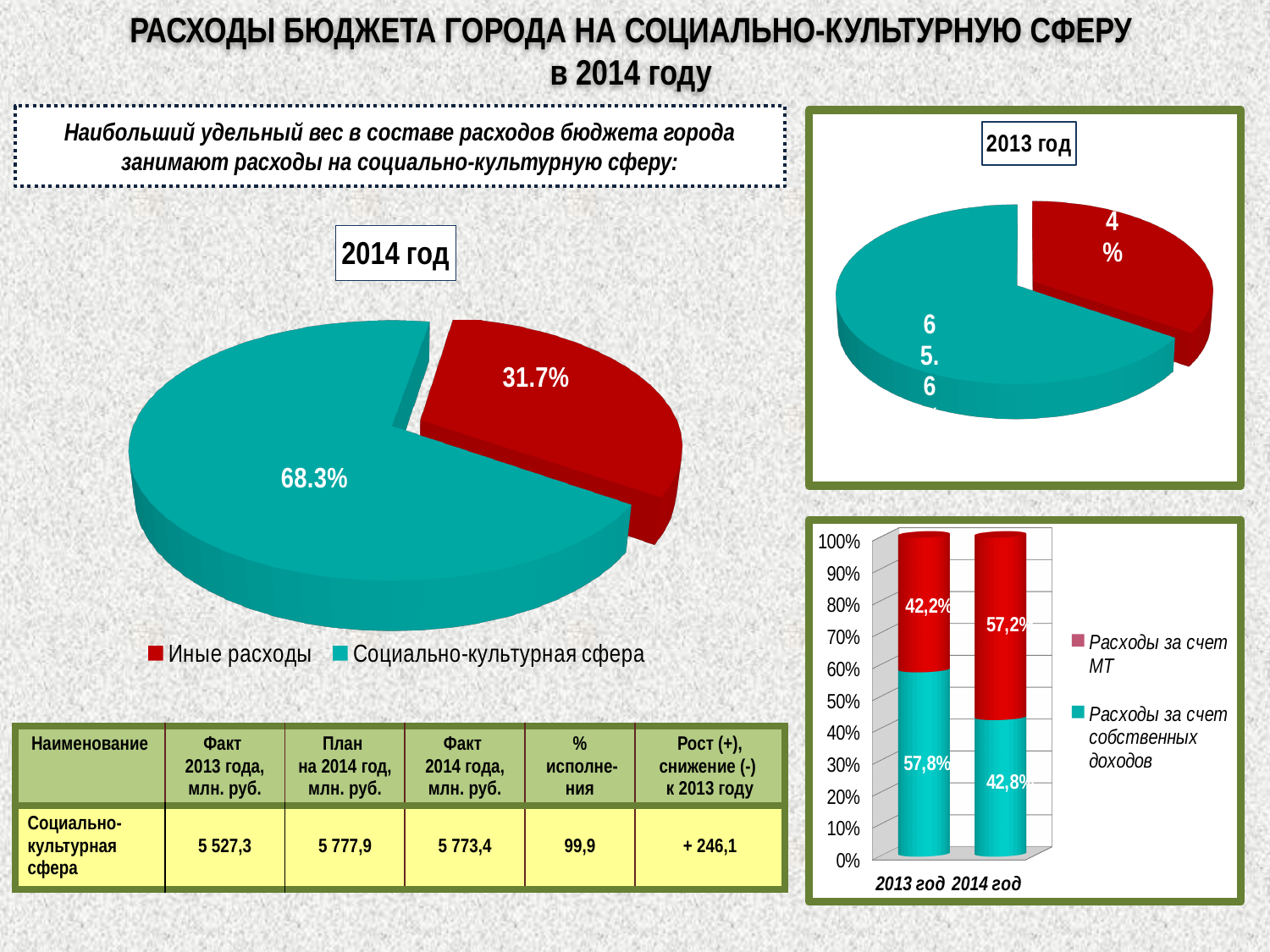
In the 2014 год pie chart, what is the difference between the Социально-культурная сфера share and the Иные расходы share? 36.6% In the 2014 год pie chart, which slice is larger: Иные расходы or Социально-культурная сфера? Социально-культурная сфера In the bottom-right stacked bar chart, what is the value of Расходы за счет собственных доходов for 2014 год? 42,8% In the 2014 год pie chart, what share is labelled for Иные расходы? 31.7% In the bottom-right stacked bar chart, what is the value of Расходы за счет собственных доходов for 2013 год? 57,8% In the bottom-right stacked bar chart, what is the value of Расходы за счет МТ for 2014 год? 57,2% In the bottom-right stacked bar chart, does the Расходы за счет собственных доходов share rise or fall from 2013 год to 2014 год? Fall How many series does the legend of the bottom-right stacked bar chart list? 2 How many slices does the 2014 год pie chart have? 2 What type of chart is the 2014 год chart on the left of the slide? Pie chart What type of chart is shown in the bottom-right panel of the slide? Bar chart In the 2014 год pie chart, what share is labelled for Социально-культурная сфера? 68.3%